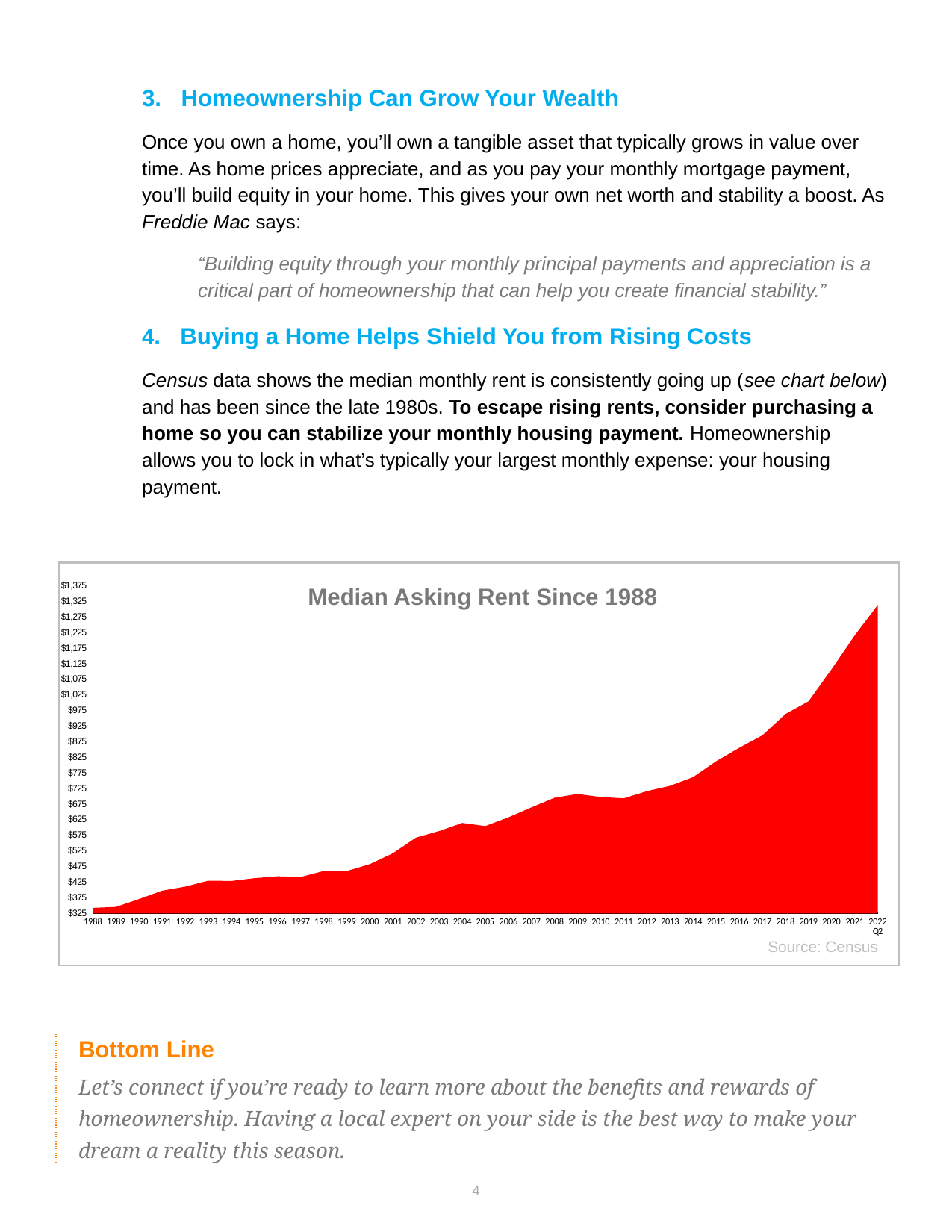
What is the title of the chart? Median Asking Rent Since 1988 Is the median asking rent for 2010 greater or less than $625? greater What kind of chart is shown on the slide? area chart Is the median asking rent for 2000 greater or less than $525? less What source is cited for the chart's data? Census Do the median asking rent values generally rise or fall from 1988 to 2022 Q2? rise Which year has a higher median asking rent, 2017 or 2021? 2021 Is the median asking rent for 1988 greater or less than $375? less Which year has the lowest median asking rent on the chart? 1988 Which year has the highest median asking rent on the chart? 2022 Q2